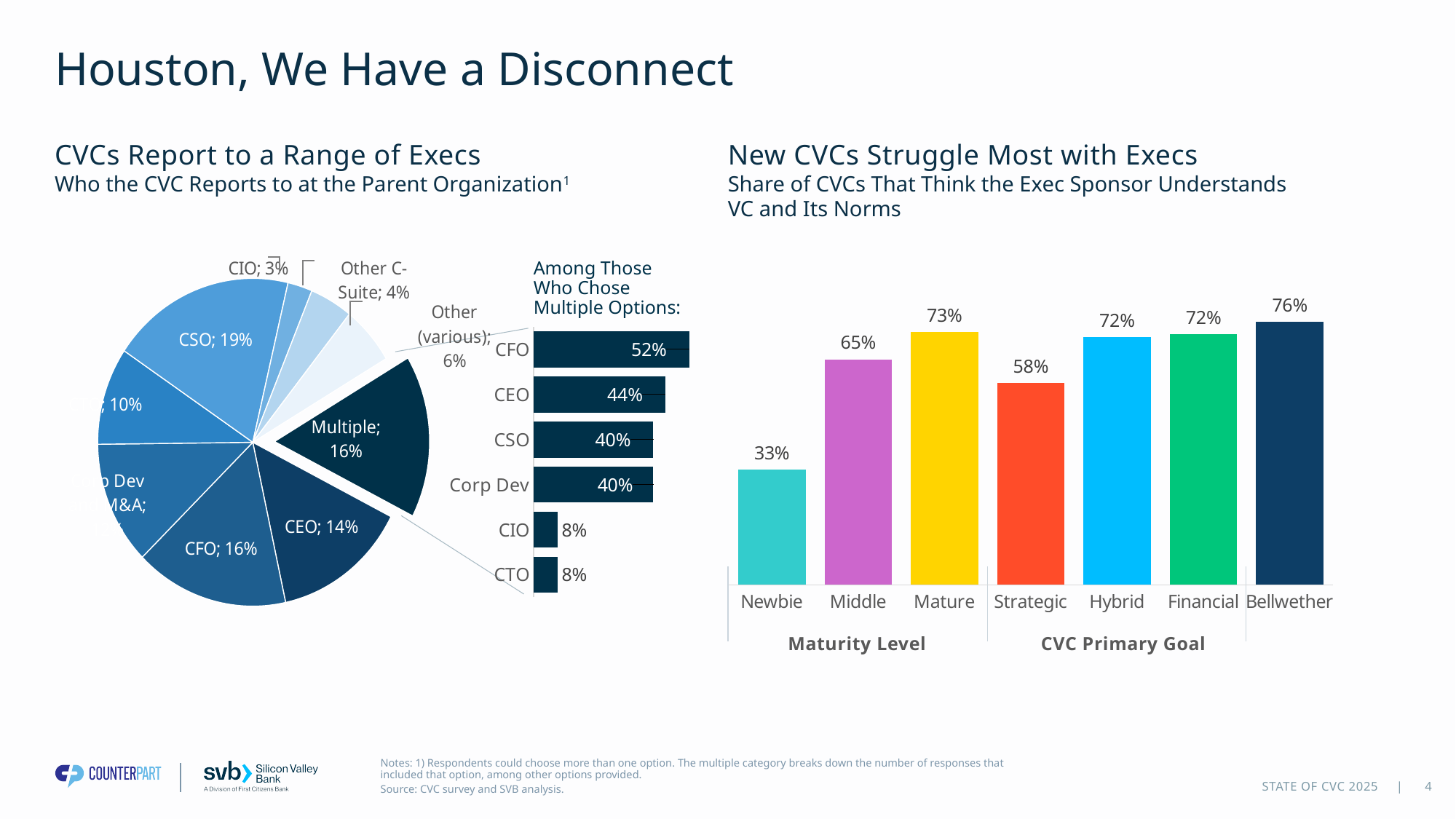
In the 'Among Those Who Chose Multiple Options' bar chart, which category has the highest value? CFO In the 'New CVCs Struggle Most with Execs' chart, which is larger, Strategic or Hybrid? Hybrid In the 'New CVCs Struggle Most with Execs' chart, do the values rise or fall from Newbie to Mature? rise In the 'Among Those Who Chose Multiple Options' bar chart, what is the value for CEO? 44% In the 'New CVCs Struggle Most with Execs' chart, what is the value for Newbie? 33% In the 'New CVCs Struggle Most with Execs' chart, which category has the highest value? Bellwether What kind of chart is 'CVCs Report to a Range of Execs'? pie chart In the 'Among Those Who Chose Multiple Options' bar chart, what is the difference between CFO and CIO? 44% In the 'CVCs Report to a Range of Execs' pie chart, what share does the CSO slice represent? 19% In the 'New CVCs Struggle Most with Execs' chart, which category has the lowest value? Newbie In the 'New CVCs Struggle Most with Execs' chart, what is the difference between Mature and Newbie? 40% In the 'New CVCs Struggle Most with Execs' chart, how many categories are shown? 7